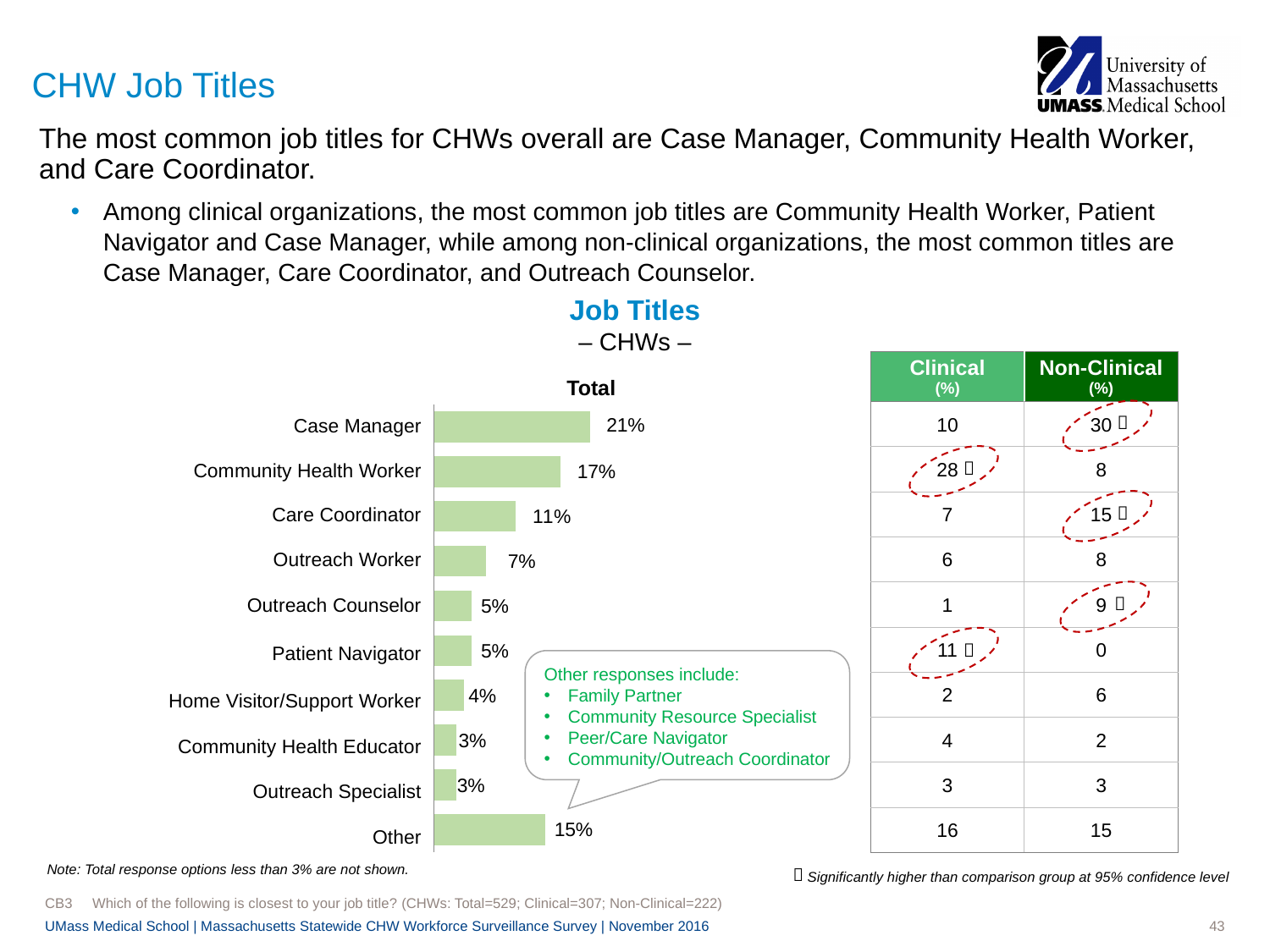
In the Job Titles chart, which has a larger Total value: Other or Care Coordinator? Other What is the Total value for Care Coordinator in the Job Titles chart? 11% What is the Total value for Case Manager in the Job Titles chart? 21% What is the difference between the Total values for Care Coordinator and Outreach Worker in the Job Titles chart? 4 percentage points What is the Total value for Home Visitor/Support Worker in the Job Titles chart? 4% Which job title has the highest Total percentage in the Job Titles chart? Case Manager What is the title of the chart on the slide? Job Titles – CHWs – What is the Total value for Community Health Worker in the Job Titles chart? 17% How many job title categories are shown in the Job Titles bar chart? 10 What is the difference between the Total values for Case Manager and Community Health Worker in the Job Titles chart? 4 percentage points What is the Total value for Other in the Job Titles chart? 15% What type of chart is used to show the Total job title percentages? Bar chart